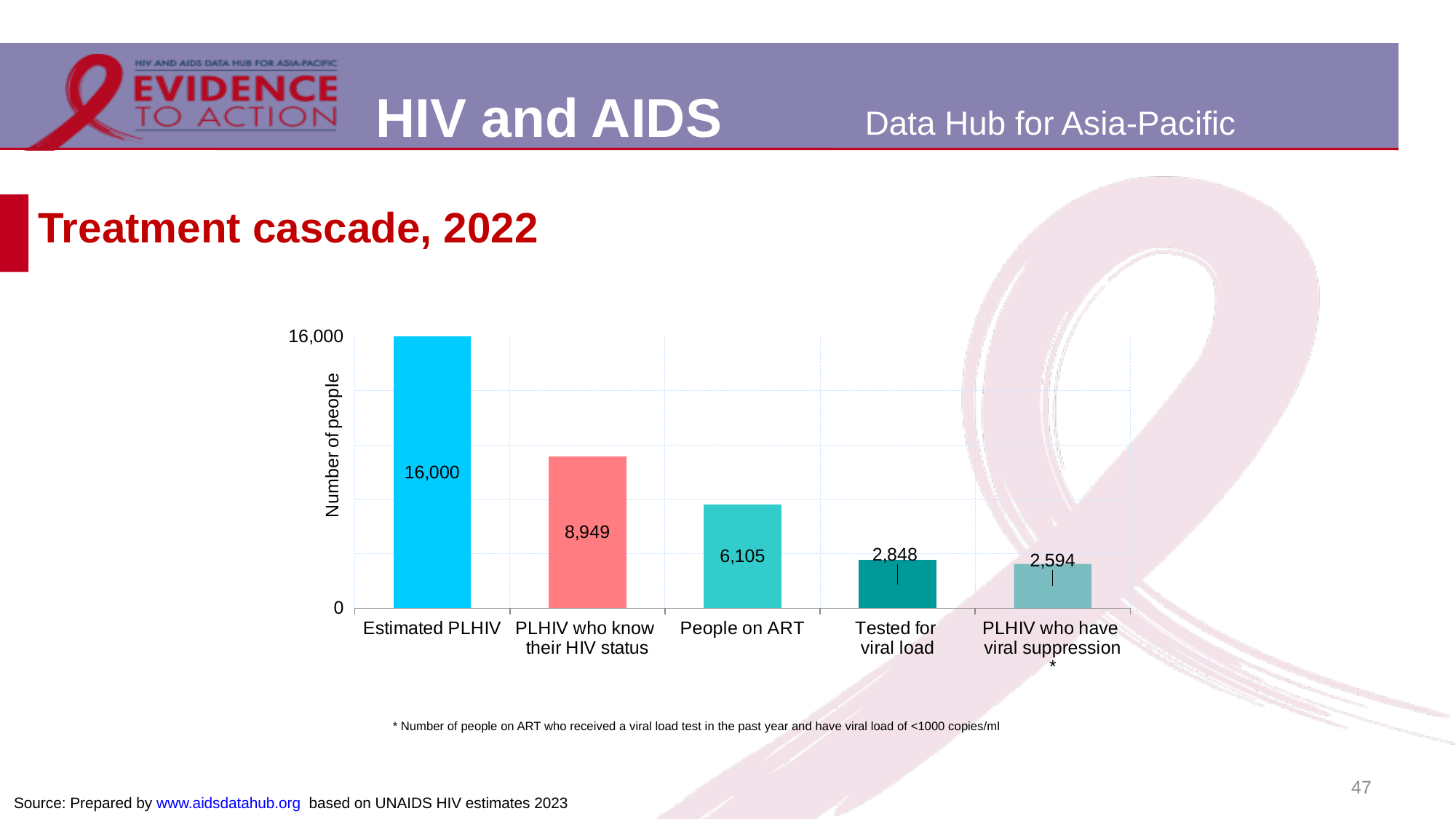
What kind of chart is shown on the slide? Bar chart What is the difference between People on ART and Tested for viral load? 3,257 What is the value for PLHIV who know their HIV status? 8,949 What is the value for PLHIV who have viral suppression? 2,594 How many categories are shown on the x axis? 5 Which is larger, PLHIV who know their HIV status or People on ART? PLHIV who know their HIV status What is the value for Tested for viral load? 2,848 What is the value for People on ART? 6,105 Which category has the lowest value? PLHIV who have viral suppression What is the value for Estimated PLHIV? 16,000 Which category has the highest value? Estimated PLHIV What is the difference between Estimated PLHIV and PLHIV who know their HIV status? 7,051